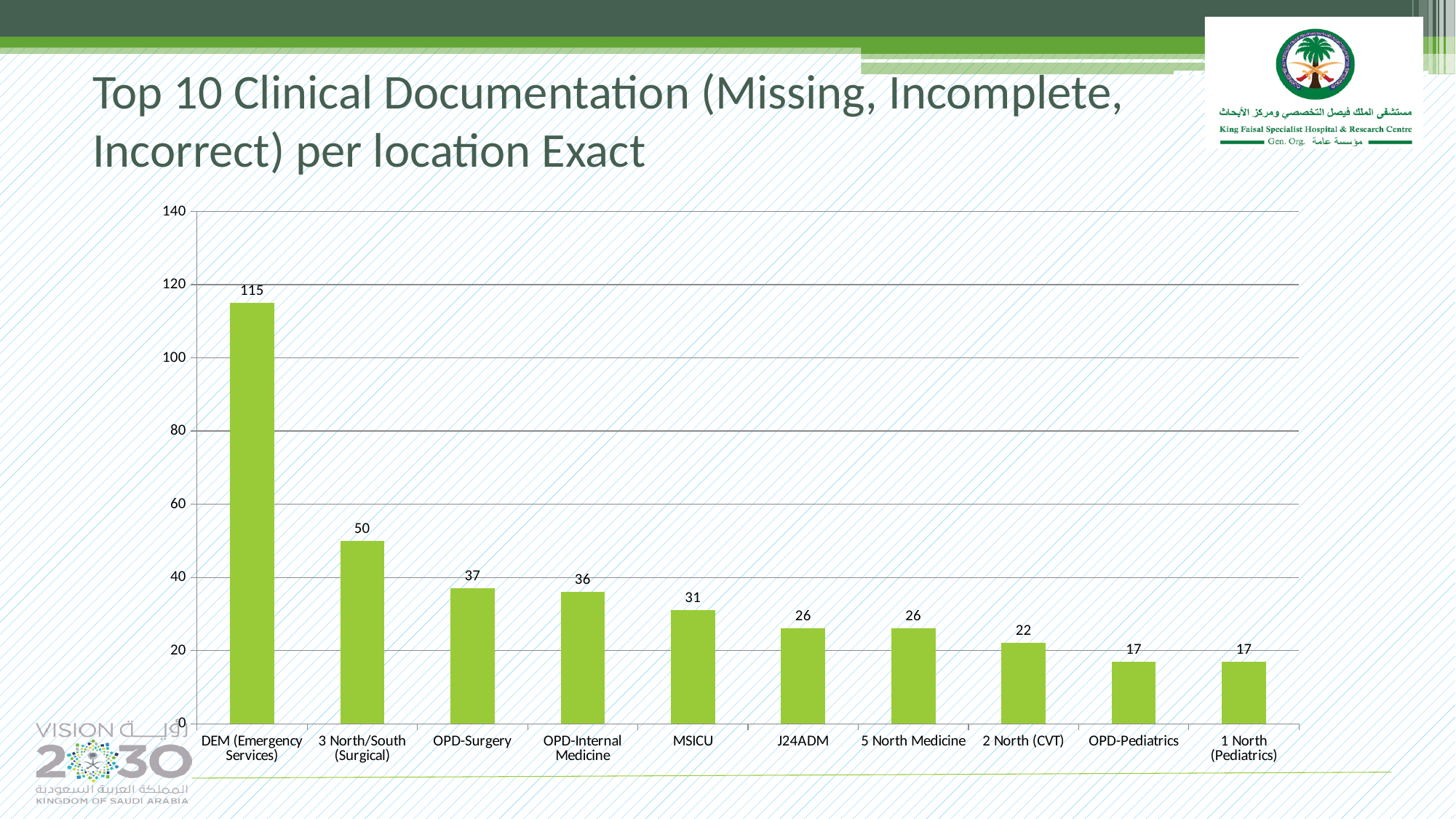
What is the value for DEM (Emergency Services)? 115 What is the value for MSICU? 31 Which location has the highest value? DEM (Emergency Services) Is the value for 3 North/South (Surgical) greater or less than 40? greater What is the value for 2 North (CVT)? 22 Do the values rise or fall from left to right along the x axis? Fall How many locations are shown on the chart? 10 What kind of chart is shown on the slide? Bar chart What is the difference between the values for OPD-Surgery and OPD-Internal Medicine? 1 What is the difference between the values for DEM (Emergency Services) and 3 North/South (Surgical)? 65 Which is larger, the value for MSICU or the value for J24ADM? MSICU What is the value for OPD-Surgery? 37